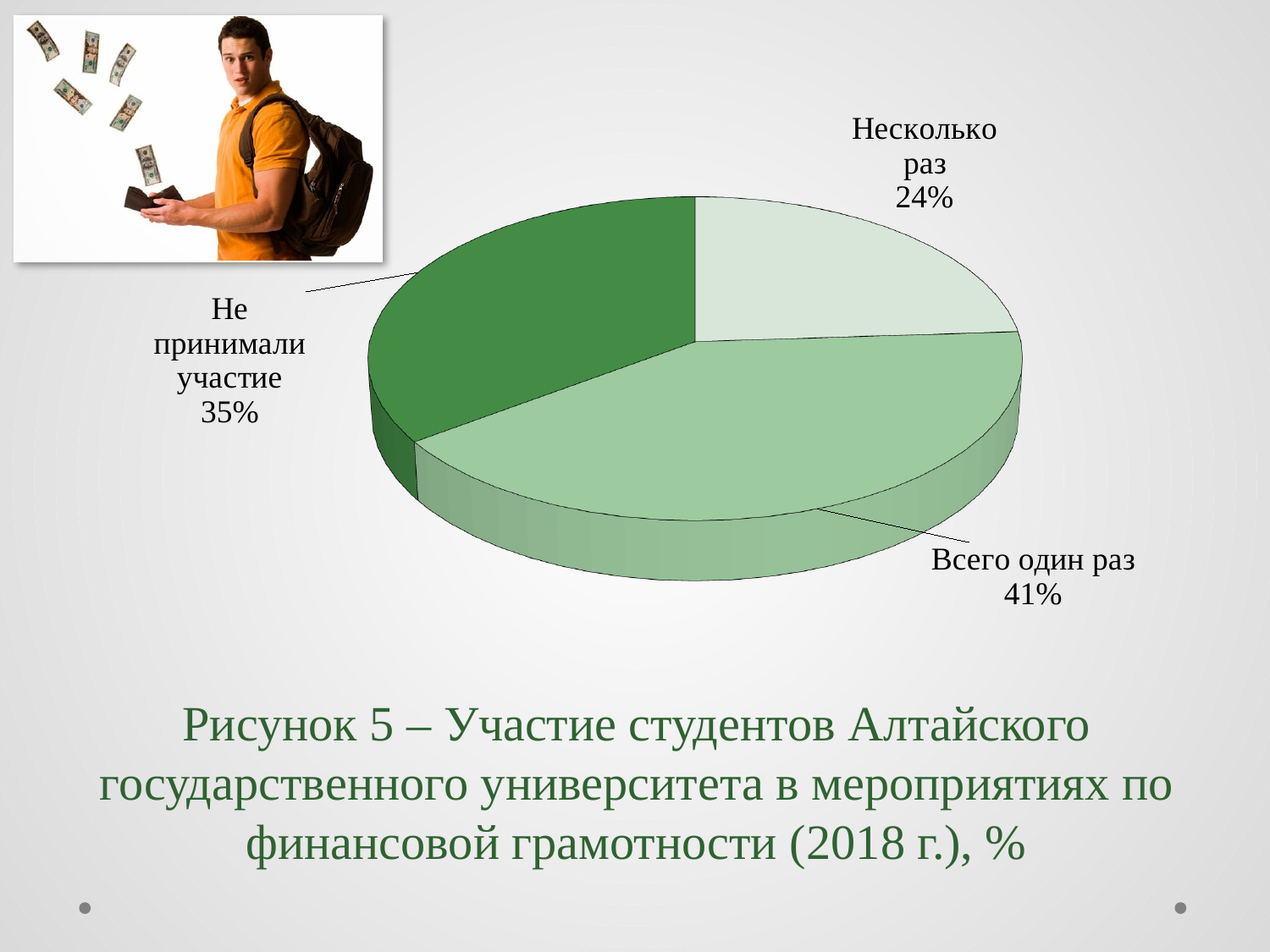
What share of the pie is labelled "Несколько раз"? 24% What share of the pie is labelled "Не принимали участие"? 35% What share of the pie is labelled "Всего один раз"? 41% How many slices does the pie chart have? 3 Which year is mentioned in the chart caption? 2018 What is the difference in percentage points between "Всего один раз" and "Не принимали участие"? 6 What is the figure number given in the caption below the chart? Рисунок 5 Which is larger: the share for "Не принимали участие" or the share for "Несколько раз"? Не принимали участие Which category has the largest slice of the pie? Всего один раз What kind of chart is shown on the slide? Pie chart What is the difference in percentage points between "Всего один раз" and "Несколько раз"? 17 Which category has the smallest slice of the pie? Несколько раз